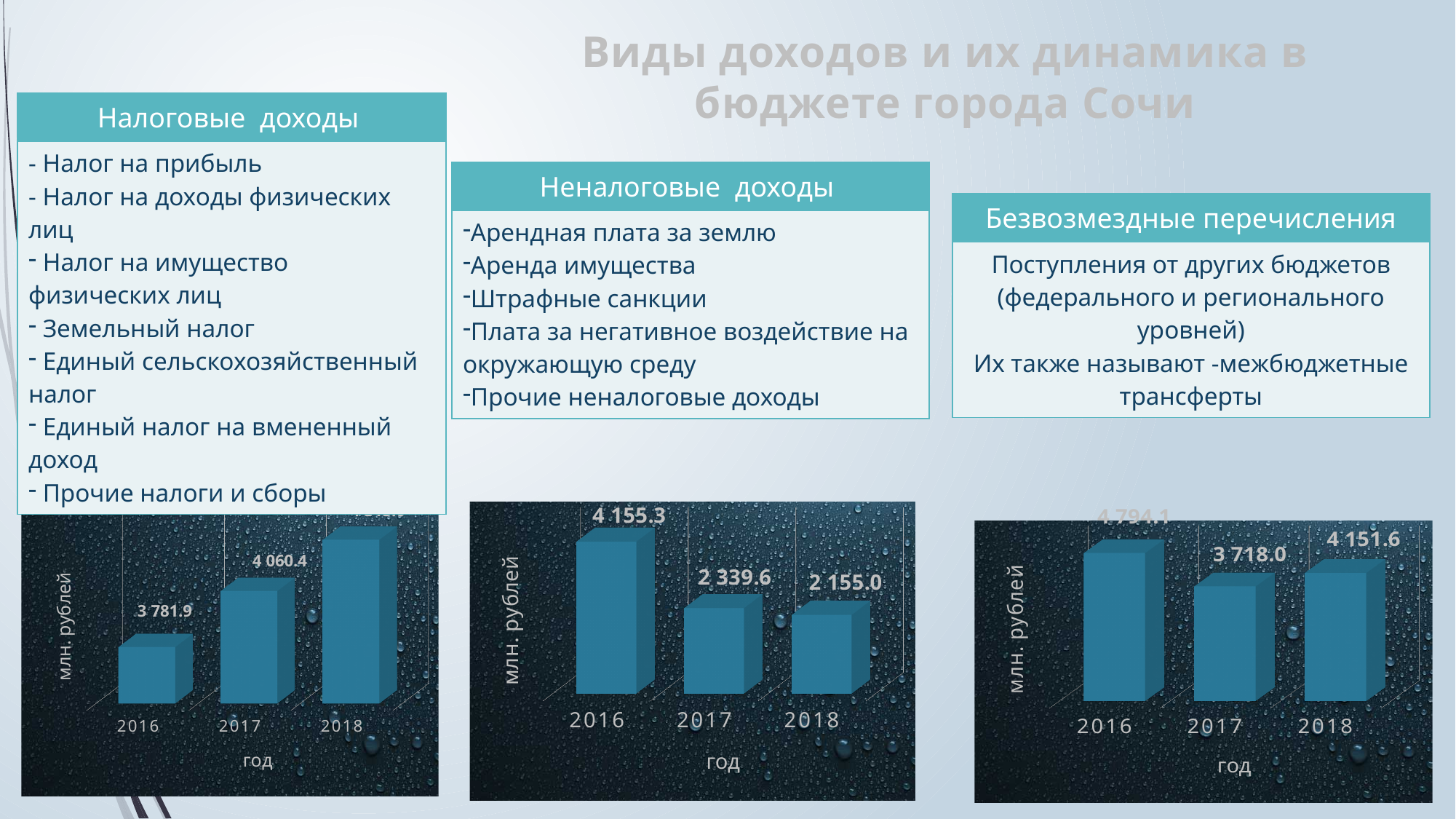
In the right chart, what is the value for 2017? 3 718.0 In the left chart, which year has the highest bar? 2018 In the right chart, what is the value for 2018? 4 151.6 In the left chart, what is the value for 2017? 4 060.4 In the middle chart, what is the difference between the 2016 and 2017 values? 1 815.7 In the left chart, do the values rise or fall from 2016 to 2018? rise How many bars does the middle chart show? 3 In the middle chart, what is the value for 2016? 4 155.3 In the right chart, which is larger, the value for 2017 or 2018? 2018 In the left chart, what is the value for 2016? 3 781.9 In the middle chart, what is the value for 2018? 2 155.0 In the middle chart, which year has the lowest value? 2018